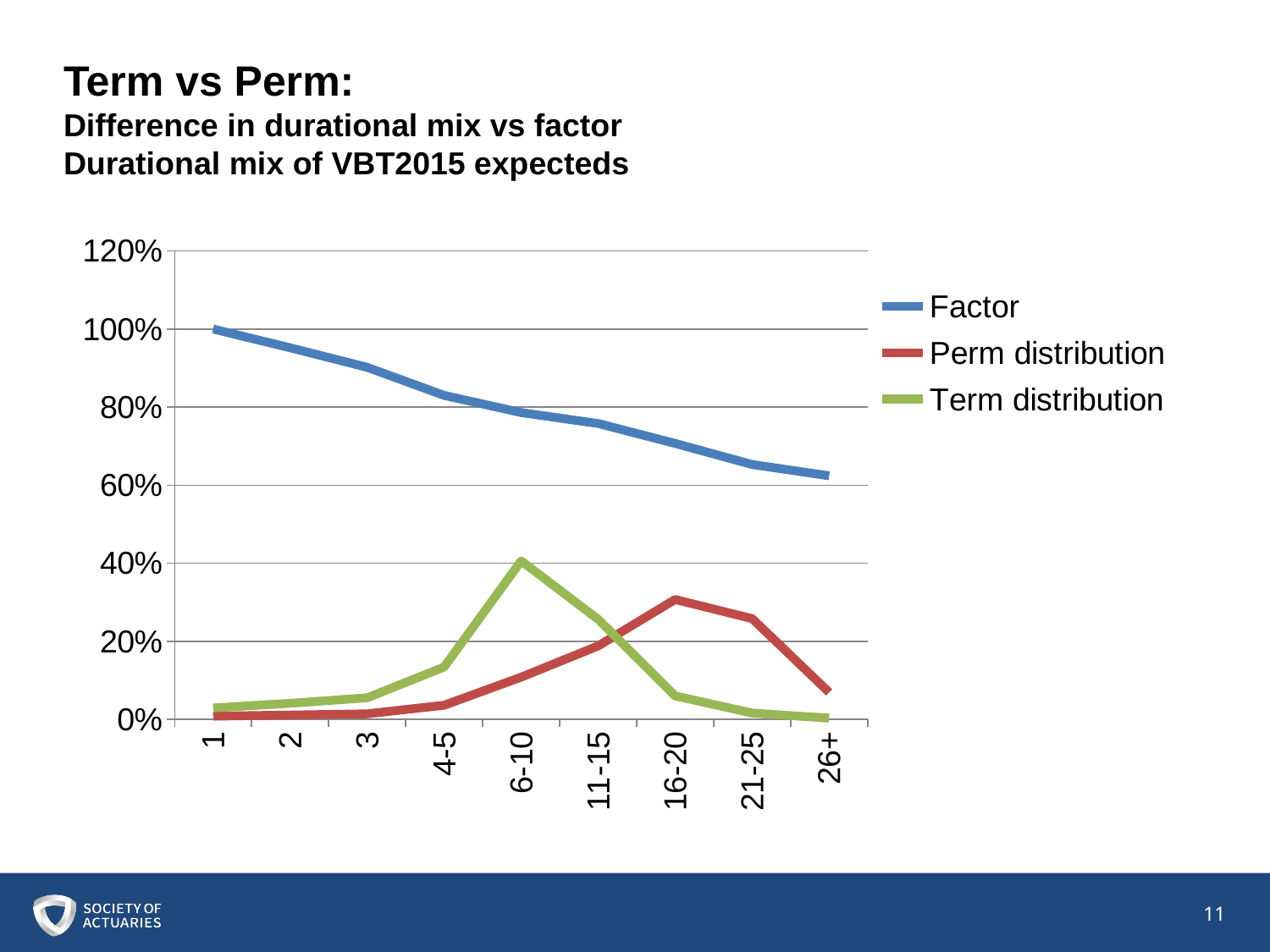
Is the Perm distribution value at 16-20 greater or less than 20%? greater At duration 6-10, which is larger: the Term distribution or the Perm distribution? Term distribution Does the Factor series rise or fall as duration increases along the x axis? fall How many series does the legend list? 3 What kind of chart is shown on the slide? line chart At which duration category is the Factor series lowest? 26+ At which duration category does the Term distribution reach its highest value? 6-10 How many duration categories are shown on the x axis? 9 Is the Factor value at 26+ greater or less than 60%? greater At which duration category does the Perm distribution reach its highest value? 16-20 What is the value of the Factor series at duration 1? 100% At duration 16-20, which is larger: the Perm distribution or the Term distribution? Perm distribution